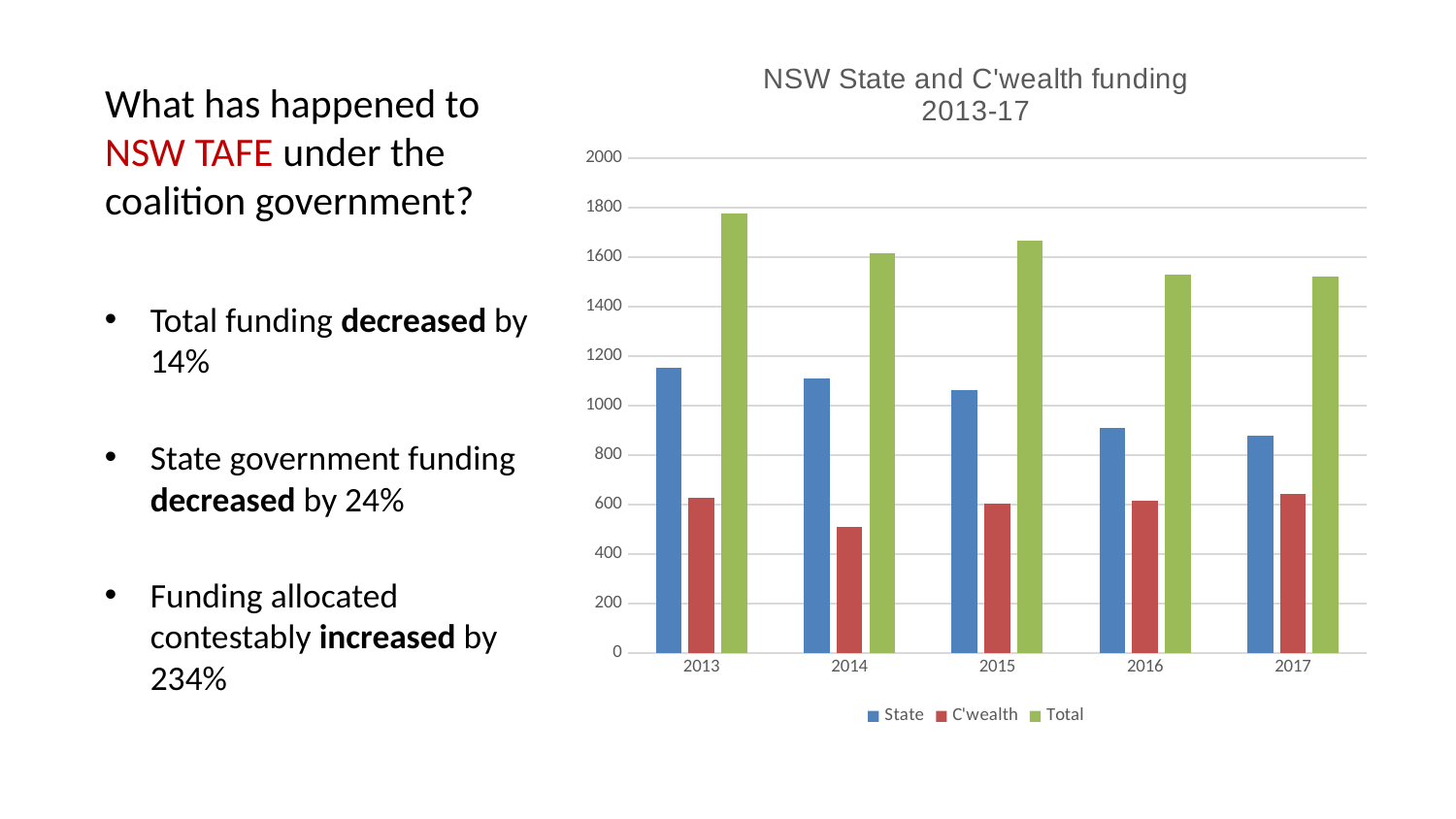
Does State funding rise or fall from 2013 to 2017? fall Which is larger, the Total funding for 2014 or for 2015? 2015 What kind of chart is shown on the slide? bar chart In which year is the State funding bar highest? 2013 How many series does the legend list? 3 Is the State funding value for 2017 greater or less than 1000? less Is the State funding value for 2013 greater or less than 1000? greater What is the title of the chart? NSW State and C'wealth funding 2013-17 In which year is the C'wealth funding bar lowest? 2014 In which year is the Total funding bar highest? 2013 How many years are shown on the x axis of the chart? 5 Is the C'wealth funding value for 2014 greater or less than 600? less